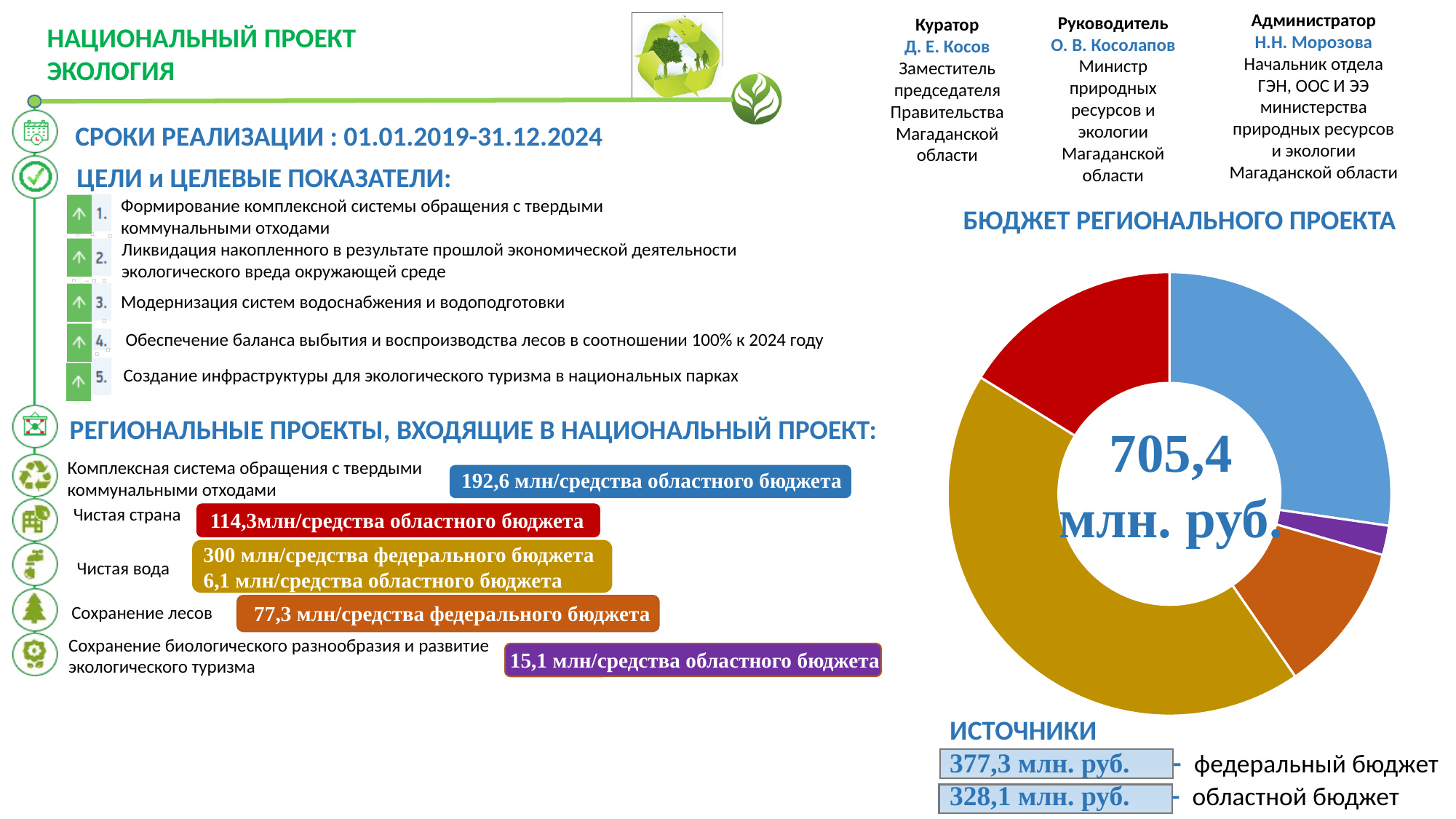
In the donut chart БЮДЖЕТ РЕГИОНАЛЬНОГО ПРОЕКТА, which colour slice is the largest? Gold (yellow) In the donut chart БЮДЖЕТ РЕГИОНАЛЬНОГО ПРОЕКТА, is the blue slice larger or smaller than the red slice? Larger In the ИСТОЧНИКИ block under the donut chart, what is the difference between the федеральный бюджет and областной бюджет amounts? 49,2 млн. руб. In the donut chart БЮДЖЕТ РЕГИОНАЛЬНОГО ПРОЕКТА, which colour slice is the smallest? Purple According to the ИСТОЧНИКИ block under the donut chart, how much comes from the областной бюджет? 328,1 млн. руб. According to the ИСТОЧНИКИ block under the donut chart, how much comes from the федеральный бюджет? 377,3 млн. руб. In the ИСТОЧНИКИ block under the donut chart, which source is larger: федеральный бюджет or областной бюджет? федеральный бюджет What kind of chart is shown under the heading БЮДЖЕТ РЕГИОНАЛЬНОГО ПРОЕКТА? Pie (donut) chart How many sources are listed in the ИСТОЧНИКИ block under the donut chart? 2 What is the title printed above the donut chart on the right side of the slide? БЮДЖЕТ РЕГИОНАЛЬНОГО ПРОЕКТА What total value is printed in the centre of the donut chart БЮДЖЕТ РЕГИОНАЛЬНОГО ПРОЕКТА? 705,4 млн. руб. How many slices does the donut chart БЮДЖЕТ РЕГИОНАЛЬНОГО ПРОЕКТА have? 5